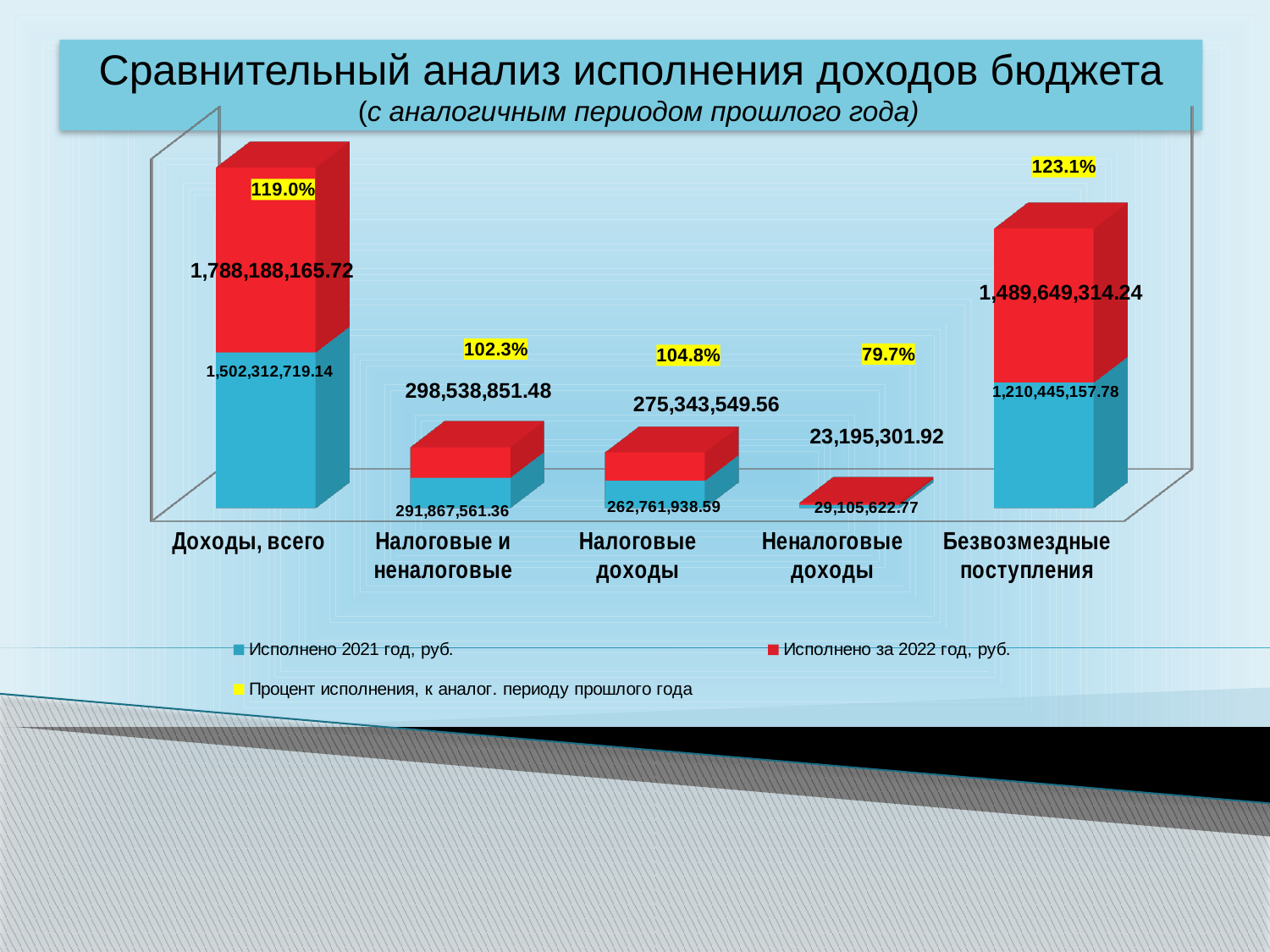
Which category has the highest 'Процент исполнения' value? Безвозмездные поступления For 'Неналоговые доходы', which is larger: the 2021 value or the 2022 value? 2021 value What kind of chart is shown on the slide? Bar chart What is the difference between the 2021 and 2022 values for 'Неналоговые доходы'? 5,910,320.85 How many series does the legend list? 3 How many categories are shown on the x axis of the chart? 5 Which category has the lowest 'Исполнено за 2022 год, руб.' value? Неналоговые доходы What percentage ('Процент исполнения') is shown for 'Неналоговые доходы'? 79.7% What is the value of 'Исполнено 2021 год, руб.' for 'Налоговые доходы'? 262,761,938.59 What is the value of 'Исполнено за 2022 год, руб.' for 'Доходы, всего'? 1,788,188,165.72 What is the value of 'Исполнено 2021 год, руб.' for 'Безвозмездные поступления'? 1,210,445,157.78 What is the difference between the 2022 and 2021 values for 'Доходы, всего'? 285,875,446.58